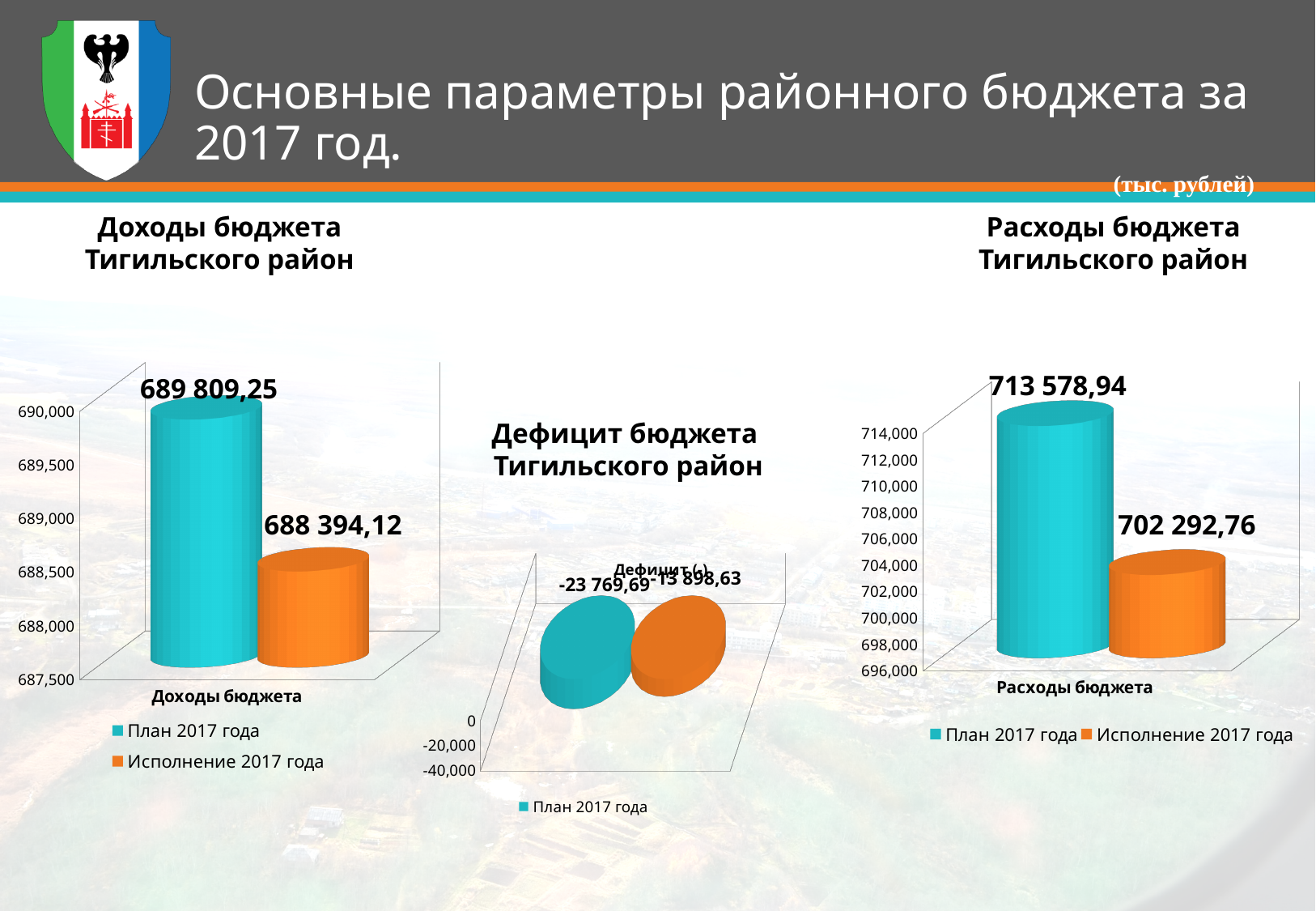
In the chart 'Расходы бюджета Тигильского район', what is the difference between План 2017 года and Исполнение 2017 года? 11 286,18 In the chart 'Расходы бюджета Тигильского район', is the value for Исполнение 2017 года greater or less than 700,000? greater In the chart 'Расходы бюджета Тигильского район', which is larger: План 2017 года or Исполнение 2017 года? План 2017 года What kind of chart is 'Расходы бюджета Тигильского район'? bar chart In the chart 'Дефицит бюджета Тигильского район', what is the value of the orange bar? -13 898,63 In the chart 'Дефицит бюджета Тигильского район', what is the value of the teal (План 2017 года) bar? -23 769,69 In the chart 'Расходы бюджета Тигильского район', what is the value for План 2017 года? 713 578,94 In the chart 'Доходы бюджета Тигильского район', what is the difference between План 2017 года and Исполнение 2017 года? 1 415,13 In the chart 'Расходы бюджета Тигильского район', what is the value for Исполнение 2017 года? 702 292,76 In the chart 'Доходы бюджета Тигильского район', what is the value for Исполнение 2017 года? 688 394,12 In the chart 'Доходы бюджета Тигильского район', is the value for Исполнение 2017 года greater or less than 689,000? less In the chart 'Доходы бюджета Тигильского район', what is the value for План 2017 года? 689 809,25